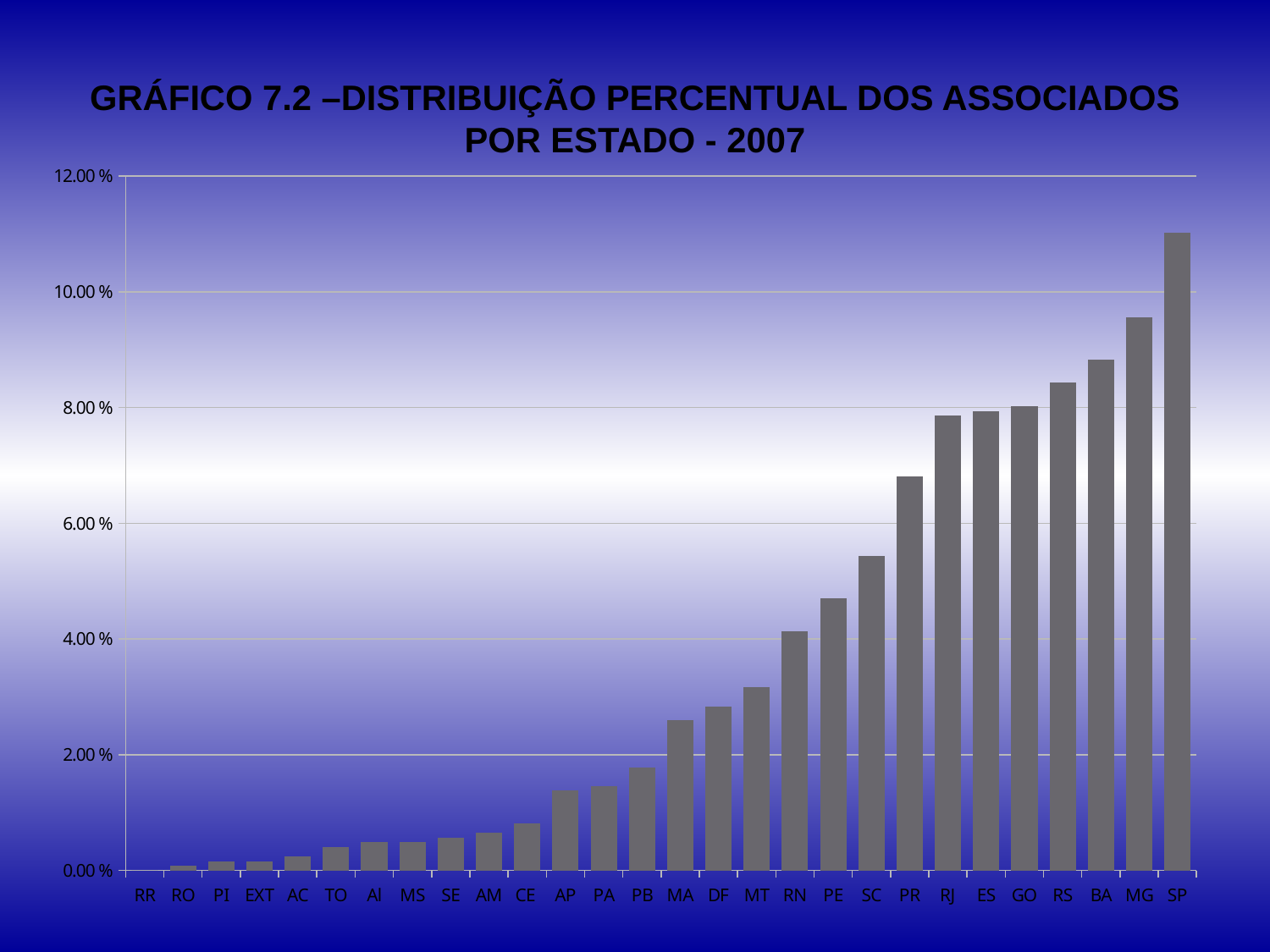
Is the value for MG greater or less than 10.00%? less Which state has the lowest percentage of associates? RR Which has the larger value, PE or RN? PE What kind of chart is shown on the slide? bar chart Is the value for MT greater or less than 4.00%? less Which state has the highest percentage of associates? SP What year does the chart title refer to? 2007 Is the value for PR greater or less than 6.00%? greater Do the values rise or fall from left to right along the x axis? rise How many states (categories) are shown on the x axis? 28